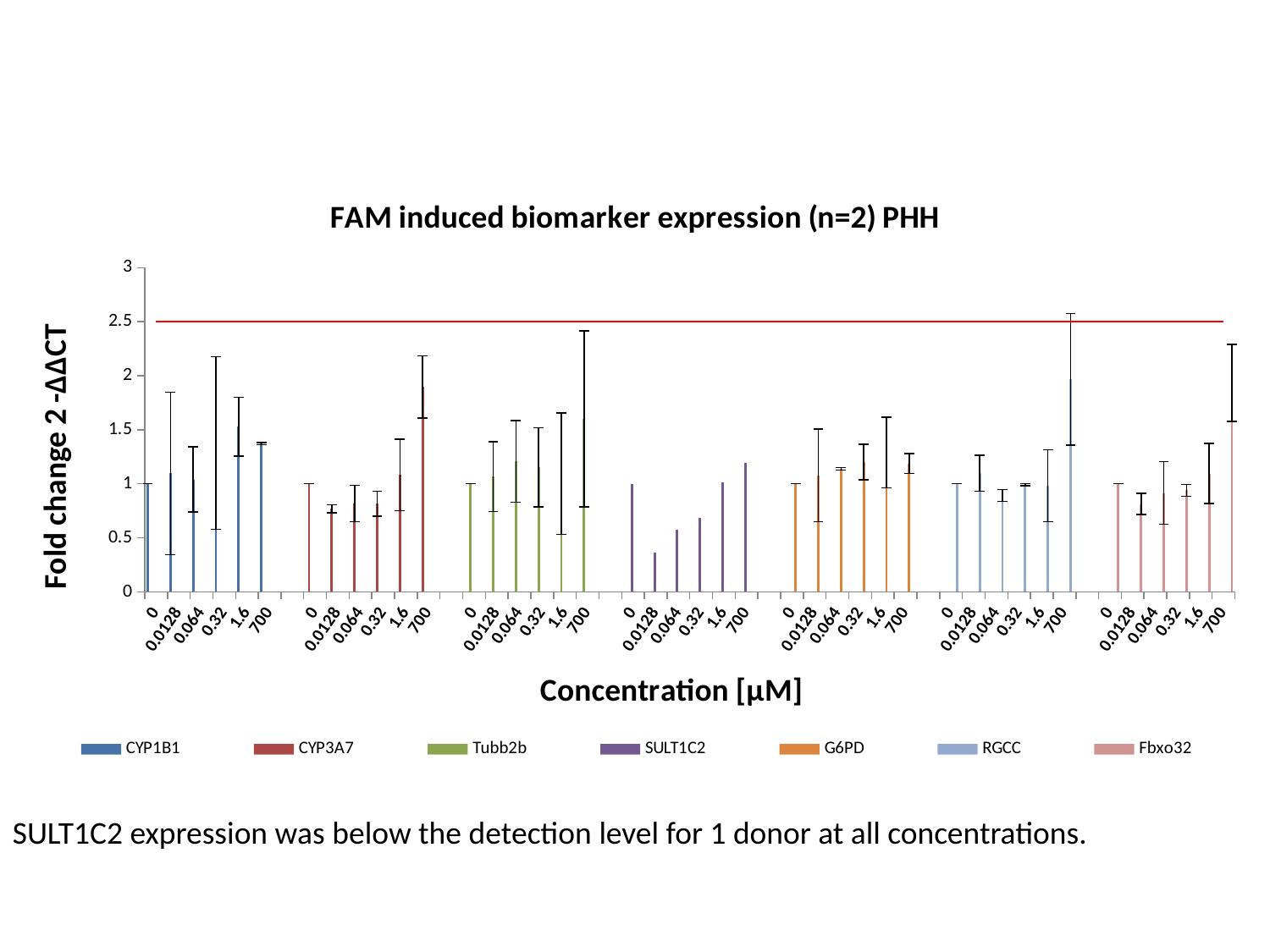
Do the SULT1C2 values rise or fall from 0.0128 to 700? rise What is the label of the x axis? Concentration [µM] What kind of chart is shown on the slide? bar chart How many series does the legend list? 7 Is the value for CYP3A7 at 700 greater or less than 1? greater At which concentration is the CYP3A7 value highest? 700 What is the title of the chart? FAM induced biomarker expression (n=2) PHH How many concentration categories are plotted for each series? 6 Which is larger, the Tubb2b value at 700 or the Tubb2b value at 0.0128? 700 Is the value for Fbxo32 at 700 greater or less than 1? greater At which concentration is the SULT1C2 value lowest? 0.0128 Is the value for SULT1C2 at 0.0128 greater or less than 0.5? less